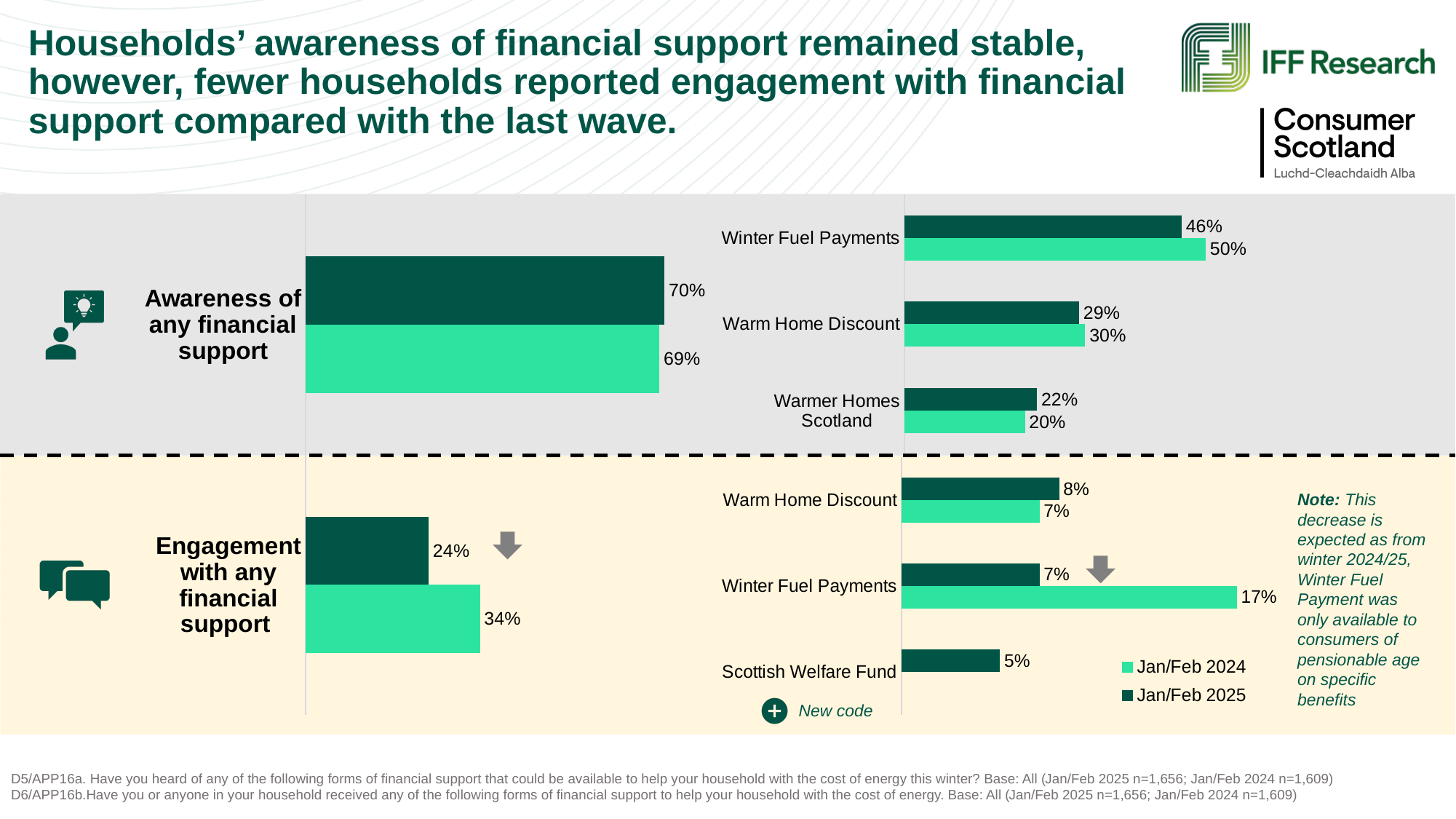
What type of chart is used for the 'Awareness of any financial support' data? Bar chart In the 'Engagement with any financial support' chart, what is the difference between the Jan/Feb 2024 and Jan/Feb 2025 values? 10 percentage points In the 'Awareness of any financial support' chart, what is the value for Jan/Feb 2025? 70% In the top-right awareness breakdown chart, which form of support has the lowest awareness in Jan/Feb 2024? Warmer Homes Scotland In the bottom-right engagement breakdown chart, what is the Jan/Feb 2024 value for Winter Fuel Payments? 17% In the 'Engagement with any financial support' chart, what is the value for Jan/Feb 2025? 24% In the bottom-right engagement breakdown chart, what is the difference between the Jan/Feb 2024 and Jan/Feb 2025 values for Winter Fuel Payments? 10 percentage points In the bottom-right engagement breakdown chart, what is the Jan/Feb 2025 value for Scottish Welfare Fund? 5% In the top-right awareness breakdown chart, which form of support has the highest awareness in Jan/Feb 2025? Winter Fuel Payments In the top-right awareness breakdown chart, what is the Jan/Feb 2024 value for Winter Fuel Payments? 50% How many series does the legend on the slide list? 2 In the 'Awareness of any financial support' chart, what is the value for Jan/Feb 2024? 69%